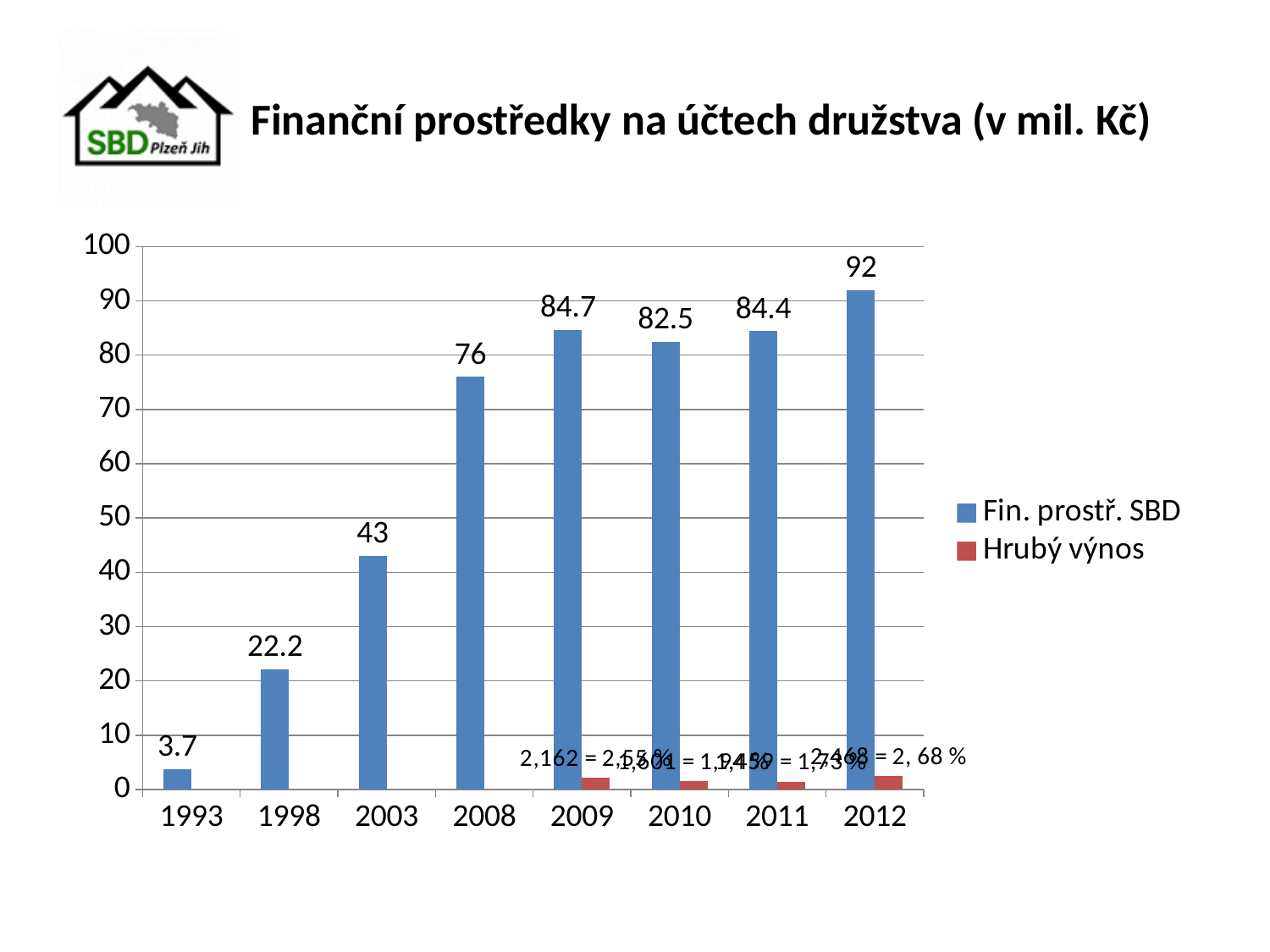
What type of chart is shown on the slide? bar chart What is the value of Fin. prostř. SBD for 2008? 76 How many years are shown on the x axis? 8 Which year has a larger Fin. prostř. SBD value, 2009 or 2010? 2009 Which year has the highest value for Fin. prostř. SBD? 2012 What is the value of Fin. prostř. SBD for 2012? 92 What is the title of the chart? Finanční prostředky na účtech družstva (v mil. Kč) How many series does the legend list? 2 Does the Fin. prostř. SBD value rise or fall from 1993 to 2008? rise What is the difference between the Fin. prostř. SBD values for 2012 and 2011? 7.6 Which year has the lowest value for Fin. prostř. SBD? 1993 What is the value of Fin. prostř. SBD for 1998? 22.2